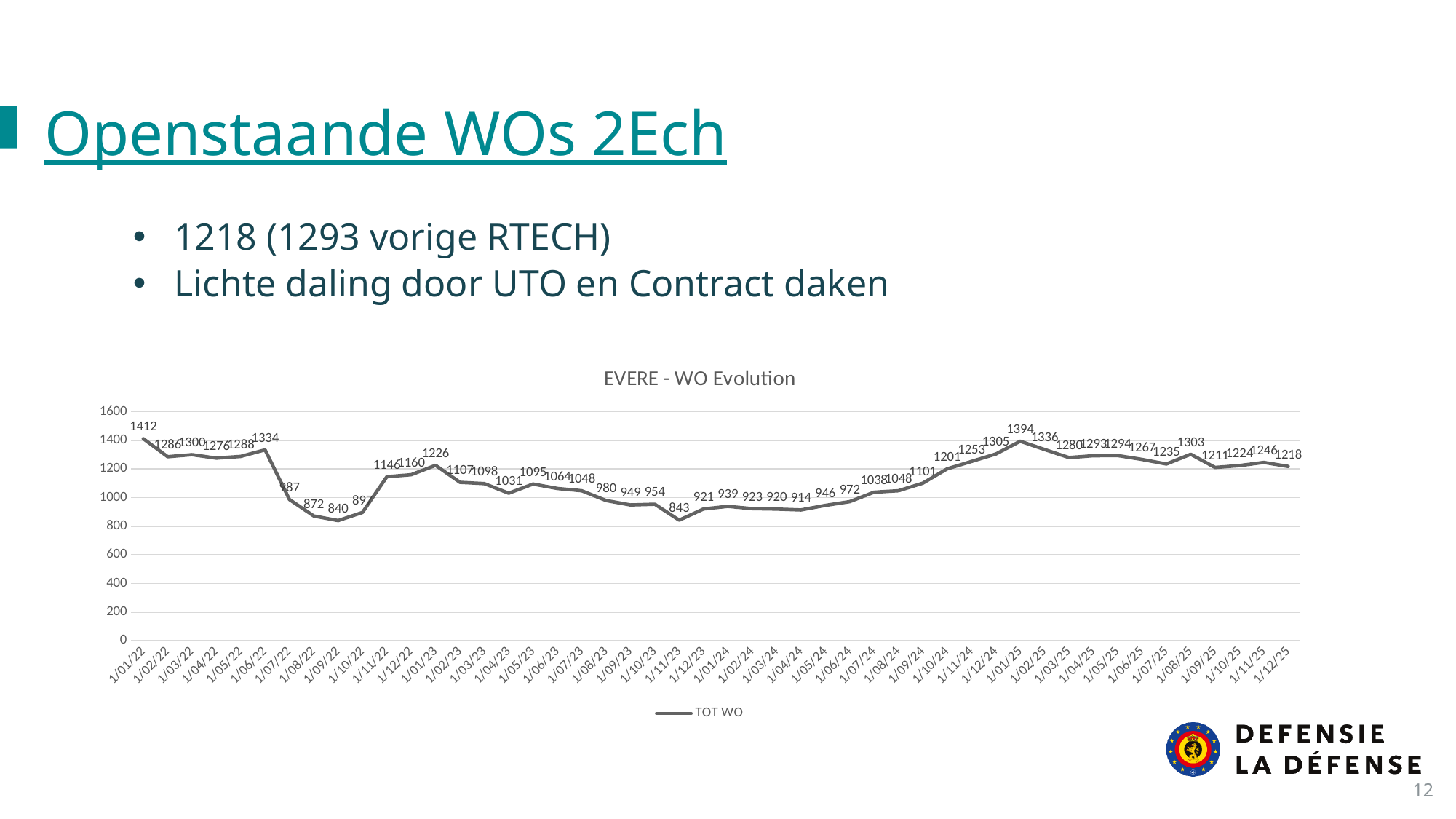
On which date is the TOT WO value highest? 1/01/22 How many data points are plotted on the line? 48 What is the value of TOT WO on 1/11/23? 843 What kind of chart is shown? line chart What is the title of the chart? EVERE - WO Evolution Is the TOT WO value on 1/04/24 greater or less than 1000? less How many series does the legend list? 1 What is the value of TOT WO on 1/01/25? 1394 What is the difference between the TOT WO values on 1/01/25 and 1/12/25? 176 Which is larger, the TOT WO value on 1/06/22 or on 1/07/22? 1/06/22 On which date is the TOT WO value lowest? 1/09/22 What is the value of TOT WO on 1/12/25? 1218